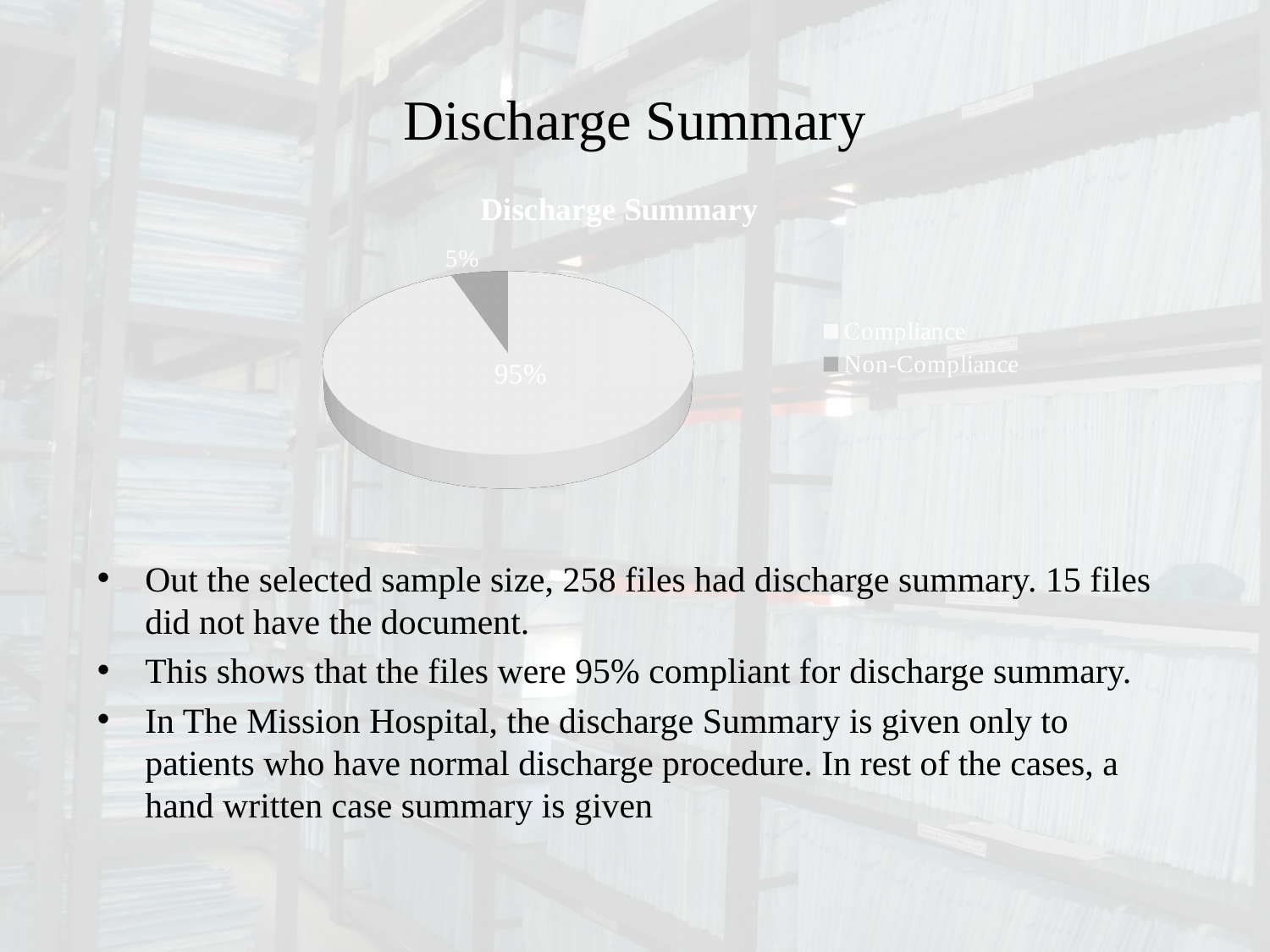
Which is larger, the Compliance slice or the Non-Compliance slice? Compliance What share of the pie does the Non-Compliance slice represent? 5% What is the difference in percentage points between the Compliance and Non-Compliance slices? 90 How many entries does the legend list? 2 What percentage of the pie is labelled Non-Compliance? 5% How many slices does the pie chart have? 2 What kind of chart is shown on the slide? pie chart What percentage of the pie is labelled Compliance? 95% Which legend entry is shown in the darker grey colour? Non-Compliance Which slice of the pie is the largest? Compliance Which slice of the pie is the smallest? Non-Compliance What is the title of the chart? Discharge Summary